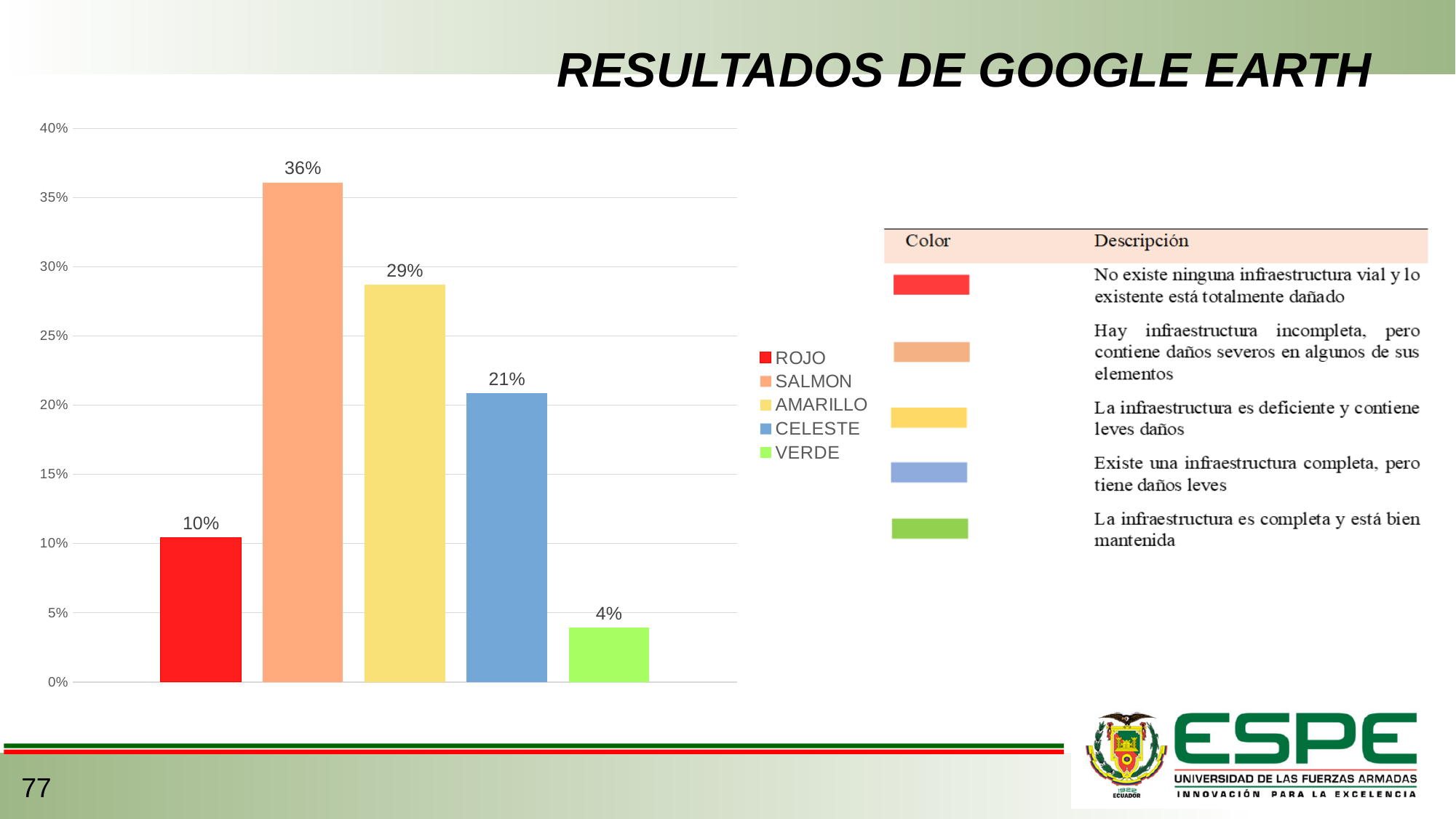
What is the difference between the values for SALMON and AMARILLO? 7% Which category has the lowest value? VERDE What kind of chart is shown on the slide? bar chart What is the value for CELESTE? 21% How many entries does the chart legend list? 5 Which is larger, the value for AMARILLO or the value for CELESTE? AMARILLO What is the value for VERDE? 4% Is the value for ROJO greater or less than 15%? less What is the difference between the values for ROJO and VERDE? 6% Which category has the highest value? SALMON What is the value for SALMON? 36% How many bars are plotted in the chart? 5